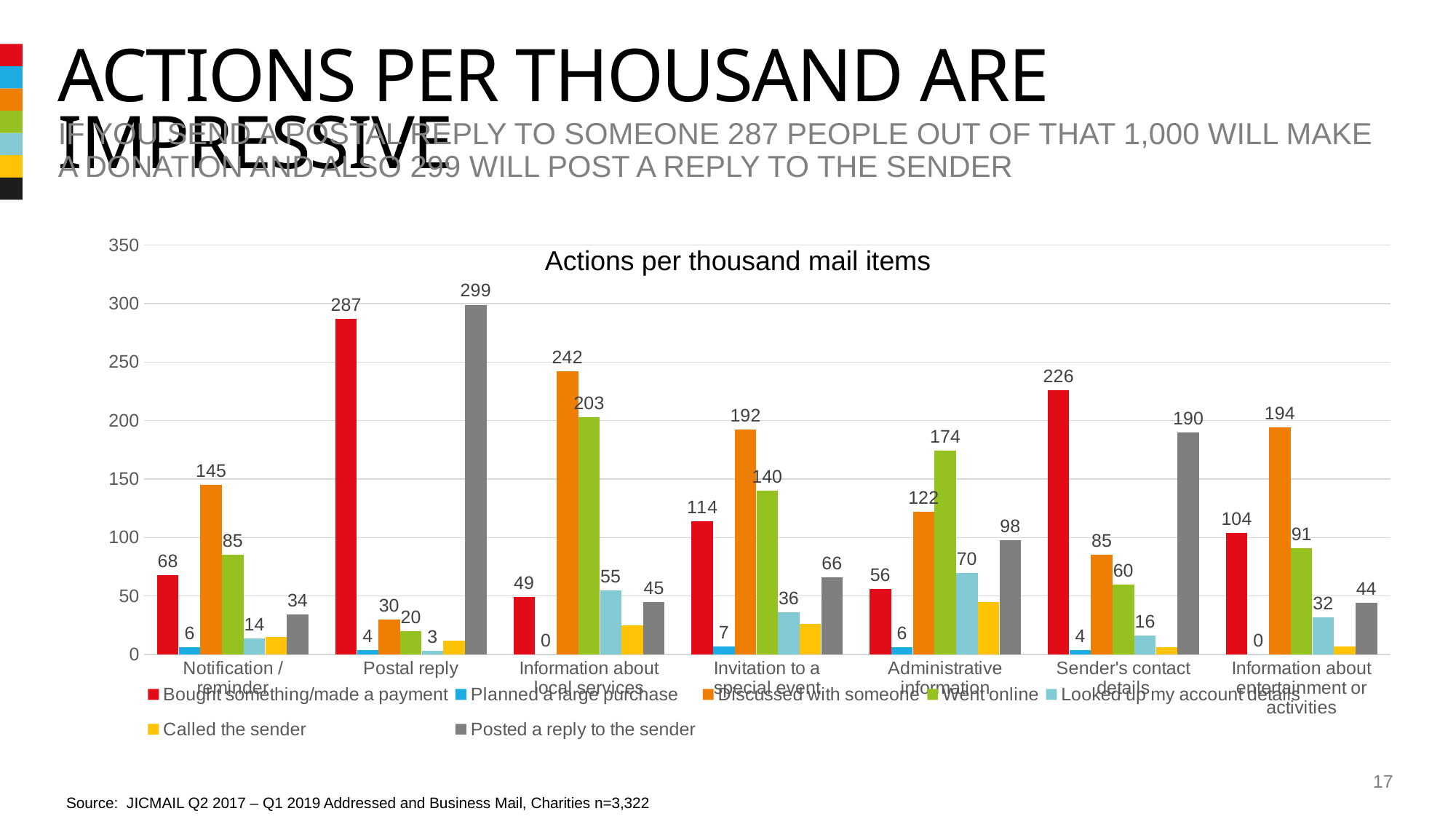
What is the value for 'Went online' in the Administrative information category? 174 What is the title of the chart? Actions per thousand mail items How many categories are shown on the x axis? 7 Which category has the highest value for 'Discussed with someone'? Information about local services What is the value for 'Posted a reply to the sender' in the Sender's contact details category? 190 In the Invitation to a special event category, which is larger: 'Discussed with someone' or 'Went online'? Discussed with someone Which category has the lowest value for 'Bought something/made a payment'? Information about local services What is the difference between 'Posted a reply to the sender' and 'Bought something/made a payment' in the Postal reply category? 12 What kind of chart is shown on the slide? Bar chart How many series does the legend list? 7 What is the value for 'Bought something/made a payment' in the Postal reply category? 287